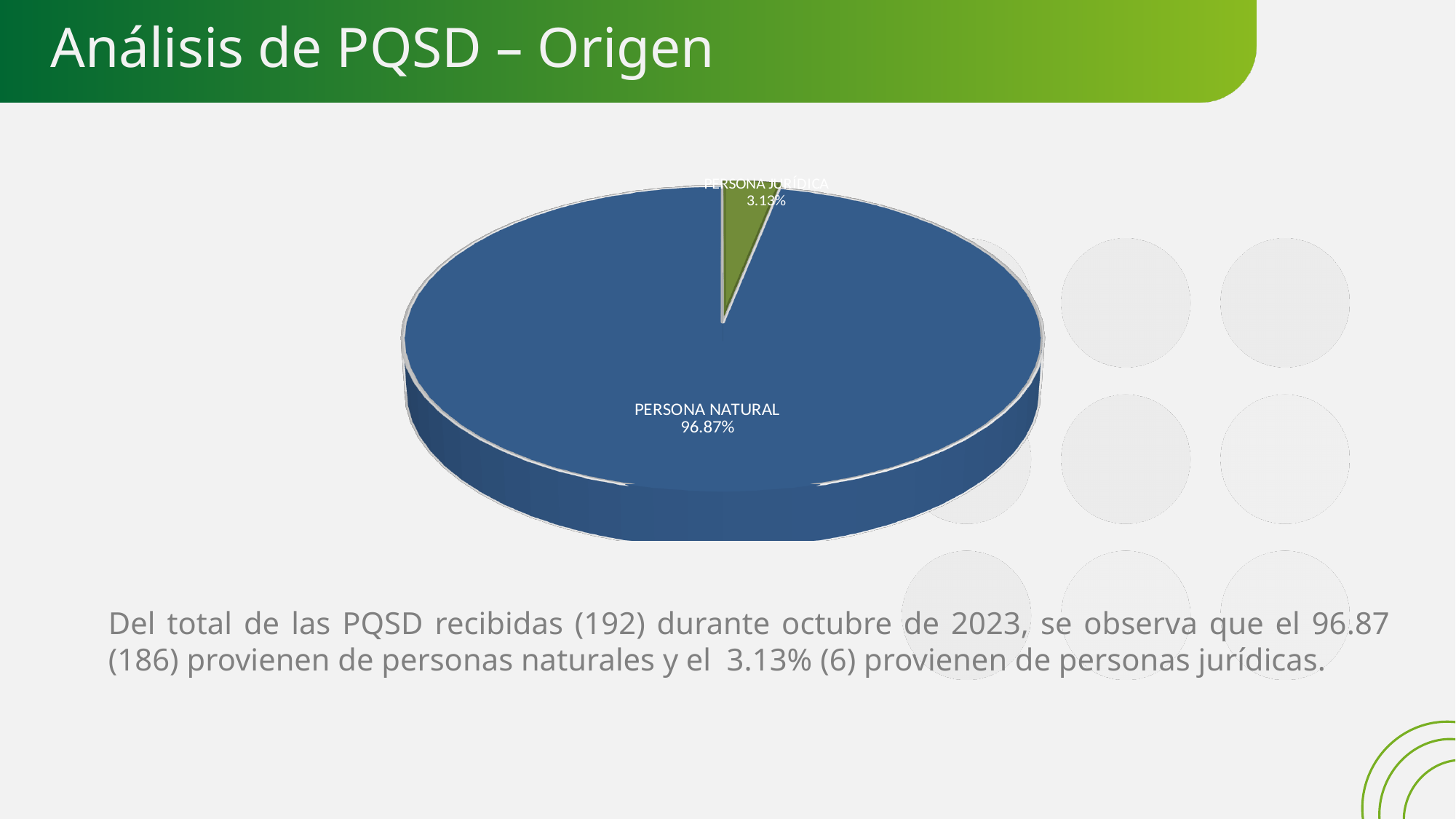
What is the difference in percentage points between PERSONA NATURAL and PERSONA JURÍDICA? 93.74% What kind of chart is shown on the slide? Pie chart How many categories are shown in the pie chart? 2 What colour is the PERSONA JURÍDICA slice? Green Which category has the smallest slice of the pie? PERSONA JURÍDICA Which is larger, the slice for PERSONA NATURAL or the slice for PERSONA JURÍDICA? PERSONA NATURAL What share of the pie does PERSONA JURÍDICA represent? 3.13% Which category has the largest slice of the pie? PERSONA NATURAL What colour is the PERSONA NATURAL slice? Blue What share of the pie does PERSONA NATURAL represent? 96.87%